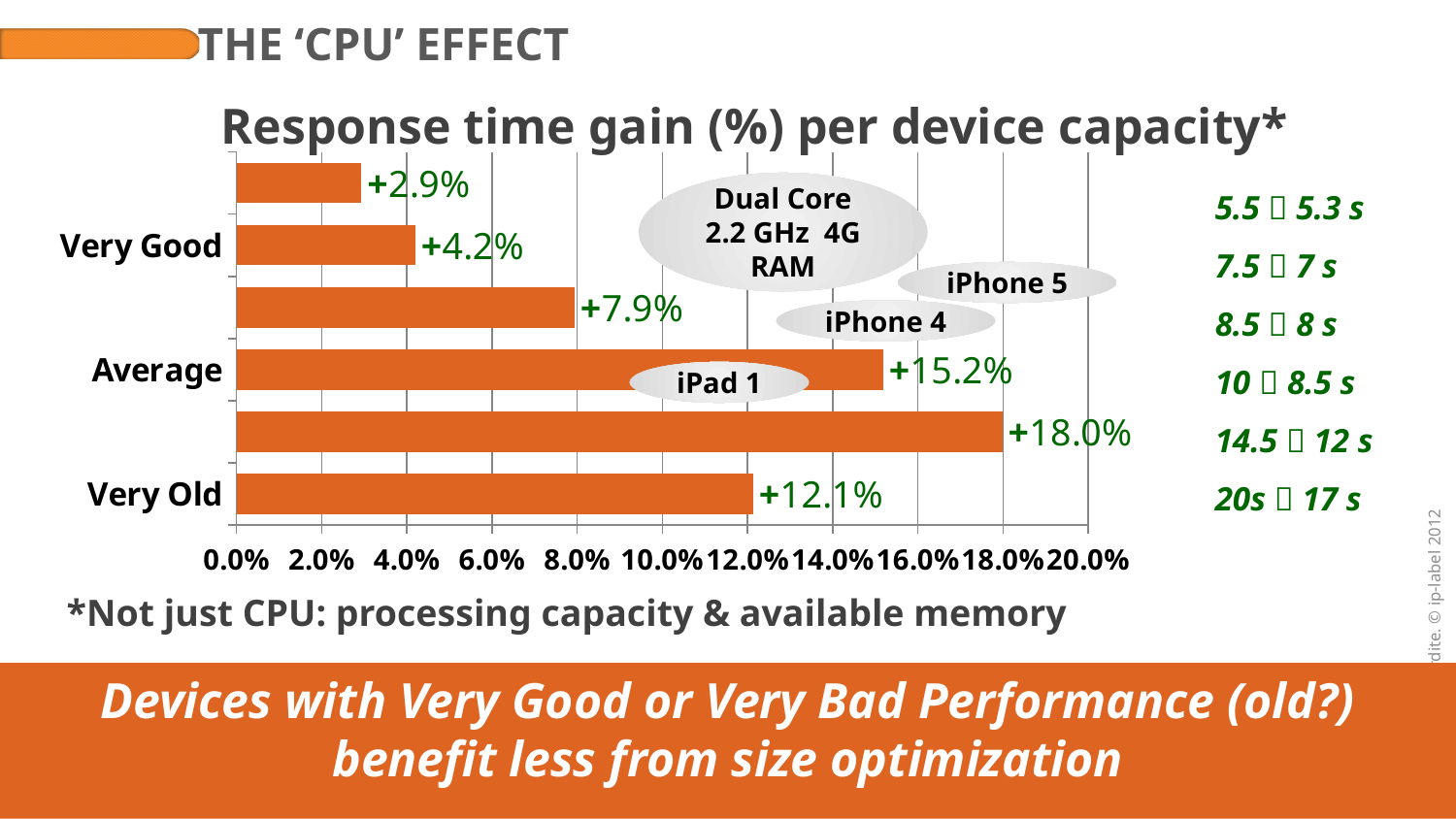
What is the title of the chart? Response time gain (%) per device capacity* What is the largest response time gain value shown on the chart? +18.0% What is the maximum value shown on the horizontal axis? 20.0% What is the response time gain for the Average category? +15.2% Which has a larger response time gain, Very Good or Very Old? Very Old How many bars are plotted on the chart? 6 What kind of chart is shown on the slide? Bar chart What is the response time gain for the Very Good category? +4.2% What is the difference in response time gain between the Average and Very Old categories? 3.1 percentage points What is the response time gain for the Very Old category? +12.1% What is the smallest response time gain value shown on the chart? +2.9% Is the value for the Average category greater or less than 14.0%? greater